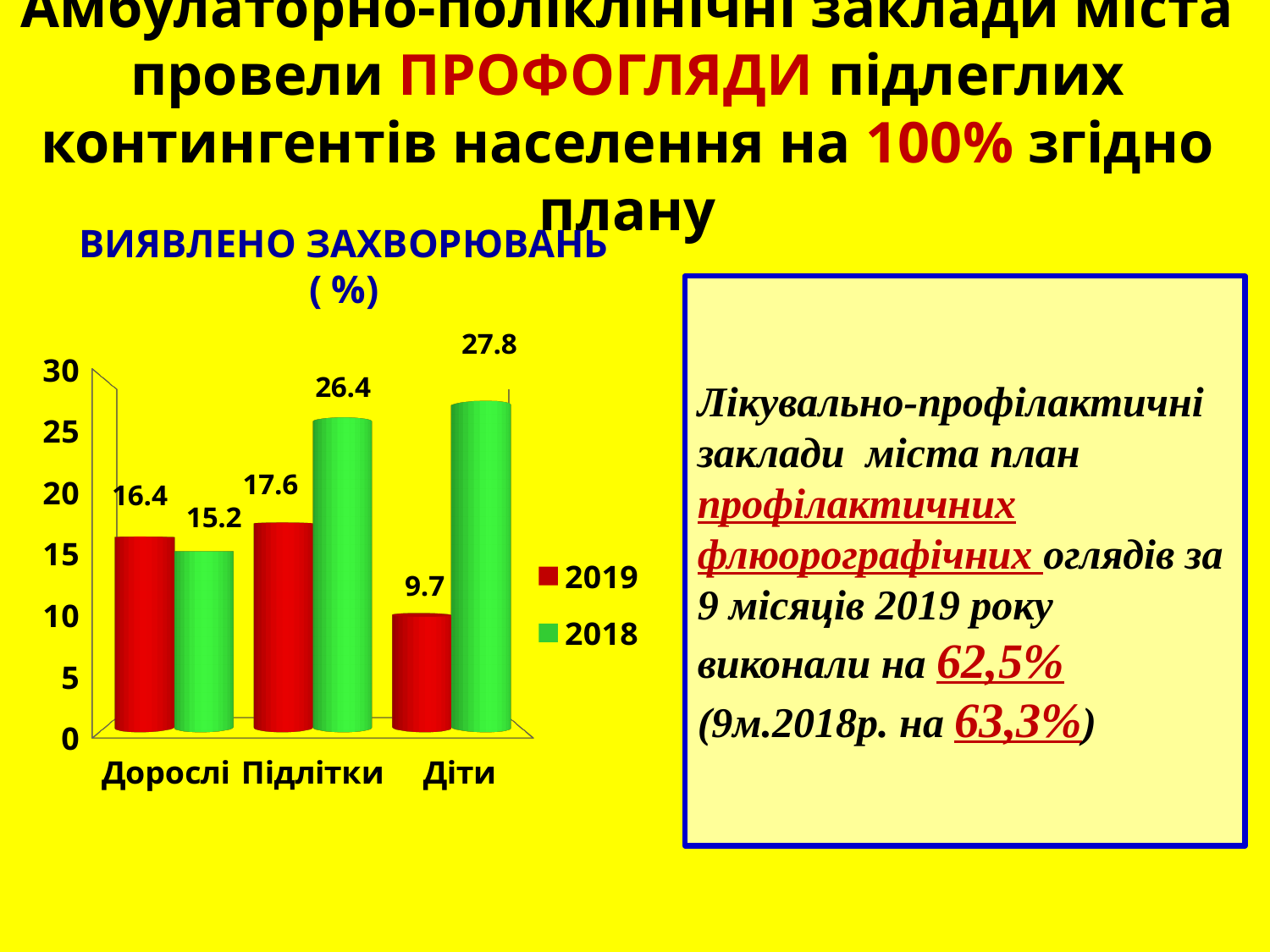
What is the value for Дорослі in the 2019 series? 16.4 How many series does the legend list? 2 How many categories are shown on the x axis? 3 What is the value for Діти in the 2018 series? 27.8 Which category has the highest value in the 2018 series? Діти Which is larger for Дорослі: the 2019 value or the 2018 value? 2019 What kind of chart is shown on the slide? bar chart What is the difference between the 2018 and 2019 values for Діти? 18.1 Is the 2018 value for Підлітки greater or less than 25? greater What is the value for Підлітки in the 2019 series? 17.6 What colour are the bars for the 2018 series? green Which category has the lowest value in the 2019 series? Діти